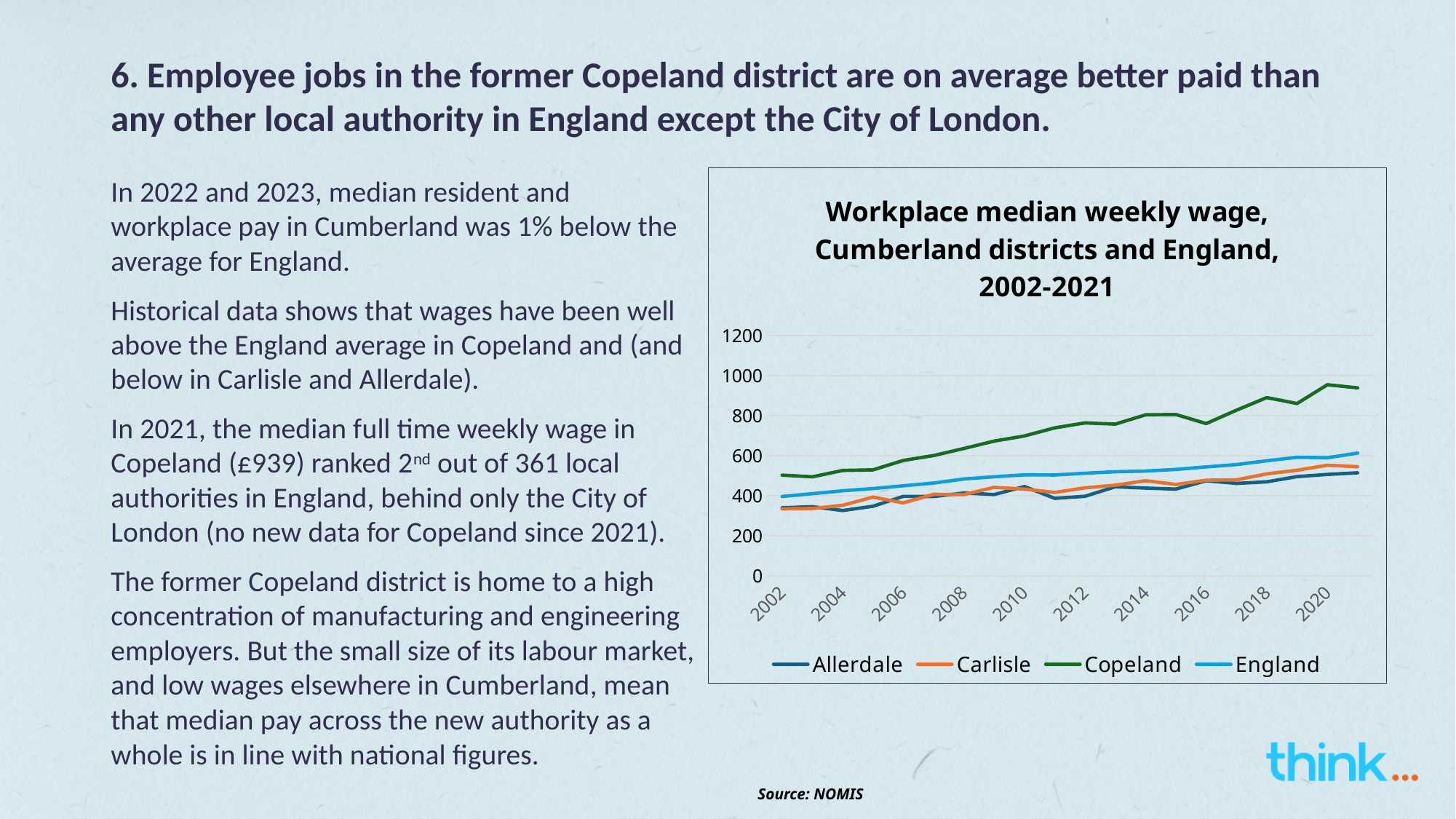
Is the value for Allerdale in 2002 greater or less than 400? less Which series is drawn in green on the chart? Copeland What kind of chart is shown on the slide? Line chart Is the value for England in 2010 greater or less than 400? greater In 2020, which is larger: the value for Copeland or the value for Allerdale? Copeland Is the value for Copeland in 2012 greater or less than 600? greater Which series has the highest workplace median weekly wage in 2020? Copeland Does the Copeland line rise or fall overall from 2002 to 2021? Rise How many series does the chart's legend list? 4 What is the title of the chart? Workplace median weekly wage, Cumberland districts and England, 2002-2021